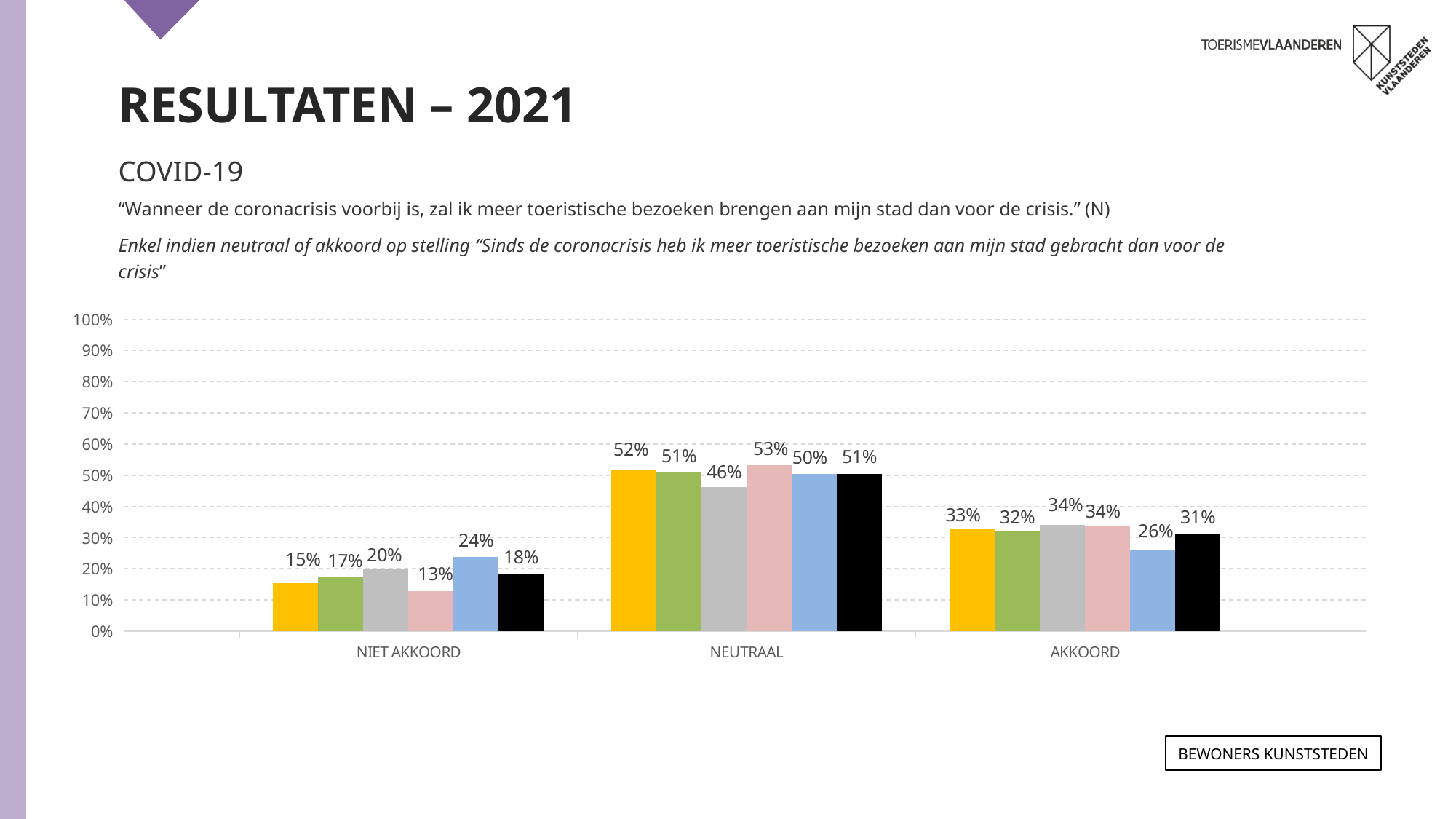
How many categories are shown on the x axis of the chart? 3 What is the value of the pink bar for AKKOORD? 34% Which is larger in the AKKOORD group: the yellow bar or the blue bar? the yellow bar (33%) How many bars are shown in each category group? 6 What is the value of the yellow bar for NEUTRAAL? 52% What is the value of the blue bar for NIET AKKOORD? 24% What is the value of the black bar for NIET AKKOORD? 18% What type of chart is shown on the slide? bar chart Which bar in the NIET AKKOORD group has the lowest value? the pink bar (13%) What is the difference between the grey bar for NEUTRAAL and the grey bar for AKKOORD? 12% What is the difference between the blue bar and the pink bar in the NIET AKKOORD group? 11% Which bar in the NEUTRAAL group has the highest value? the pink bar (53%)